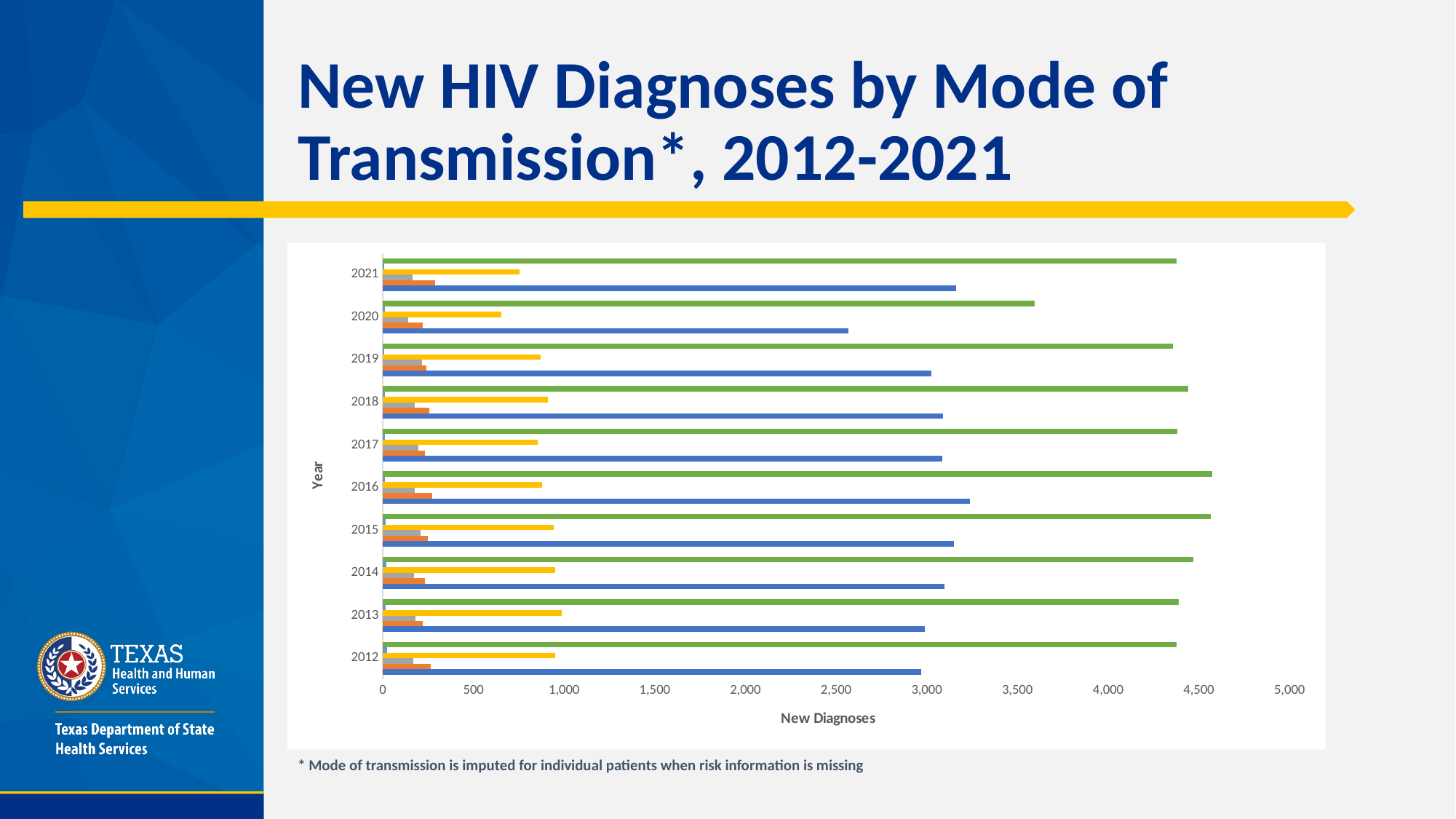
Which year has the shortest blue bar? 2020 Which year has the shortest green bar? 2020 Is the blue bar for 2020 greater or less than 3,000? less How many years are shown on the vertical axis of the chart? 10 Is the green bar for 2020 greater or less than 3,500? greater Is the yellow bar for 2021 greater or less than 1,000? less What is the title of the chart's vertical axis? Year What is the title of the chart's horizontal axis? New Diagnoses Which is longer, the blue bar for 2021 or the blue bar for 2020? 2021 What kind of chart is shown on the slide? Bar chart